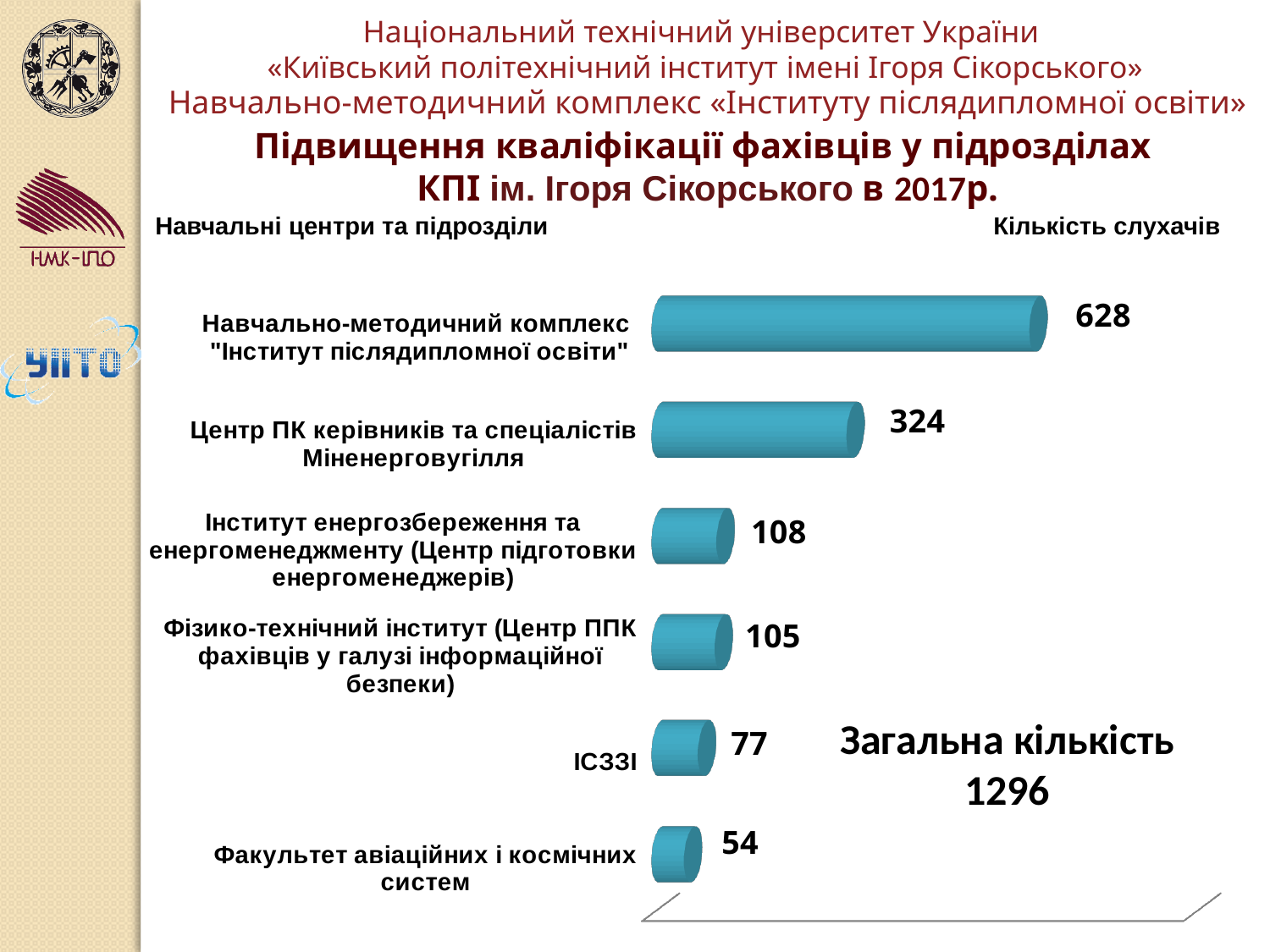
How many units (categories) are shown in the chart? 6 What is the value shown for Факультет авіаційних і космічних систем? 54 What type of chart is shown on the slide? Bar chart What is the number of listeners for Навчально-методичний комплекс "Інститут післядипломної освіти"? 628 What is the value shown for ІСЗЗІ? 77 Which has a larger value: ІСЗЗІ or Факультет авіаційних і космічних систем? ІСЗЗІ What is the difference between the values for Навчально-методичний комплекс "Інститут післядипломної освіти" and Центр ПК керівників та спеціалістів Міненерговугілля? 304 Which unit has the highest number of listeners? Навчально-методичний комплекс "Інститут післядипломної освіти" Which unit has the lowest number of listeners? Факультет авіаційних і космічних систем What is the value shown for Центр ПК керівників та спеціалістів Міненерговугілля? 324 What is the difference between the values for Інститут енергозбереження та енергоменеджменту and Фізико-технічний інститут? 3 What is the total number of listeners (Загальна кількість) stated on the slide? 1296